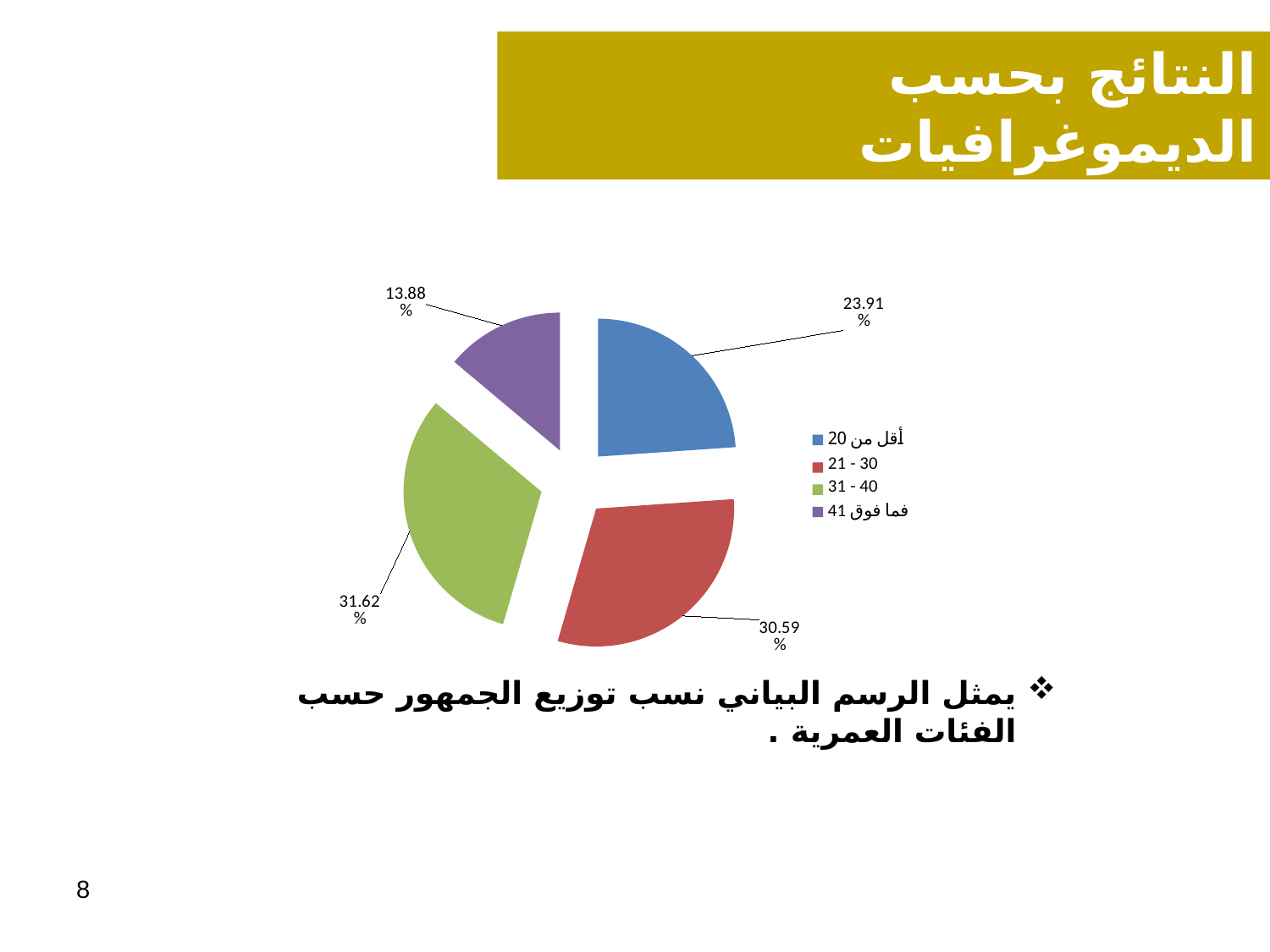
What percentage of the pie chart is the slice for أقل من 20? 23.91% What percentage is shown for the 41 فما فوق slice? 13.88% Which age group has the largest slice in the pie chart? 31 - 40 What colour is the slice for 31 - 40 in the pie chart? Green Which age group has the smallest slice in the pie chart? 41 فما فوق How many slices does the pie chart have? 4 What is the difference in percentage points between the 21 - 30 slice and the أقل من 20 slice? 6.68 What is the difference in percentage points between the 31 - 40 slice and the 41 فما فوق slice? 17.74 What is the value shown for the 31 - 40 slice? 31.62% What type of chart is shown on the slide? Pie chart Which slice is larger, 21 - 30 or أقل من 20? 21 - 30 What percentage does the 21 - 30 slice represent in the pie chart? 30.59%